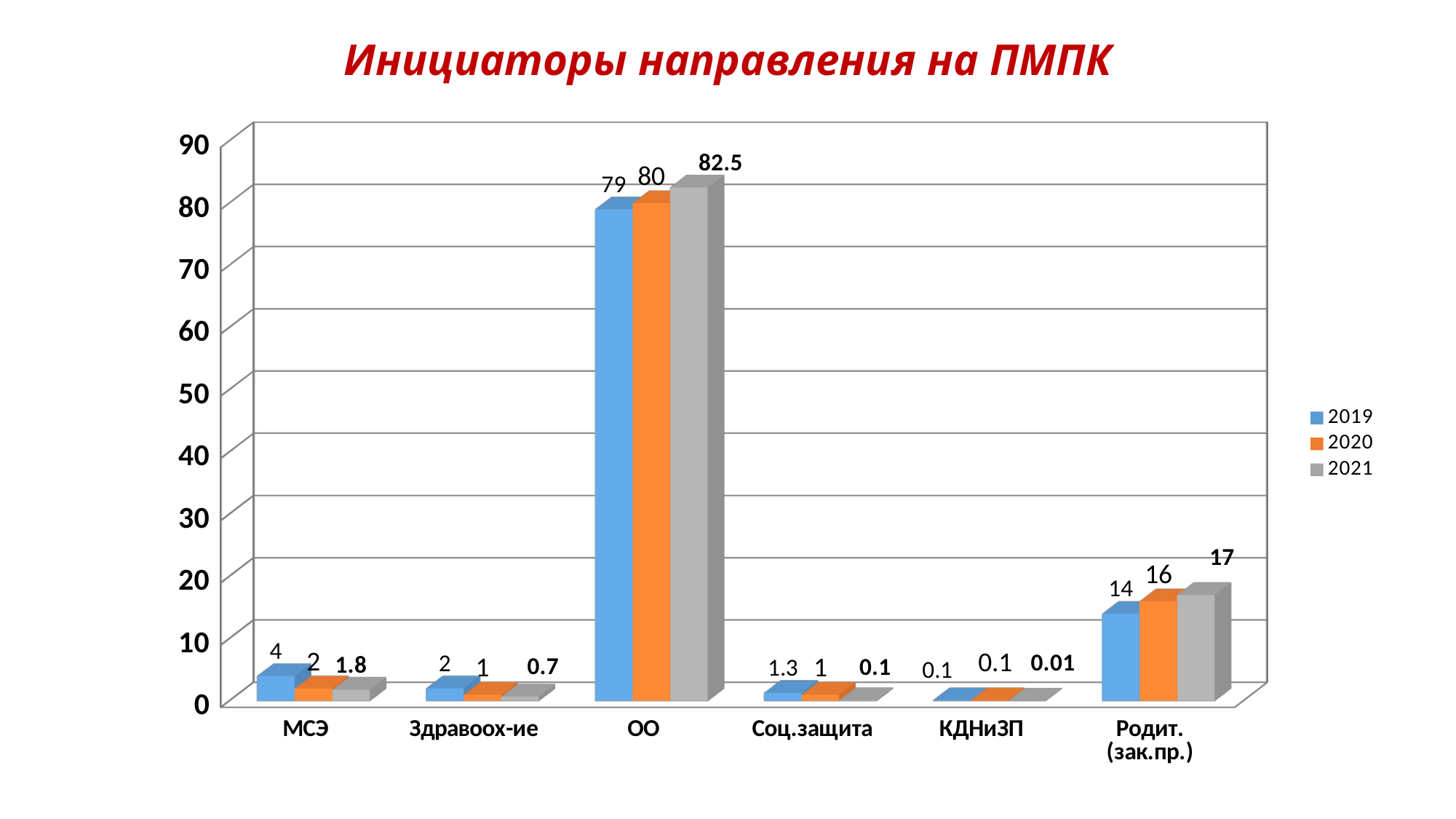
What is the difference between the 2021 and 2019 values for ОО? 3.5 Which category has the highest value in 2020? ОО What is the value for МСЭ in 2020? 2 How many series does the legend list? 3 What is the value for ОО in 2021? 82.5 What is the value for Родит. (зак.пр.) in 2019? 14 How many categories are shown on the x axis? 6 What kind of chart is shown on the slide? bar chart What is the value for КДНиЗП in 2021? 0.01 Which category has the lowest value in 2021? КДНиЗП Which is larger: the 2019 value for МСЭ or the 2019 value for Здравоох-ие? МСЭ Do the values for Родит. (зак.пр.) rise or fall from 2019 to 2021? rise